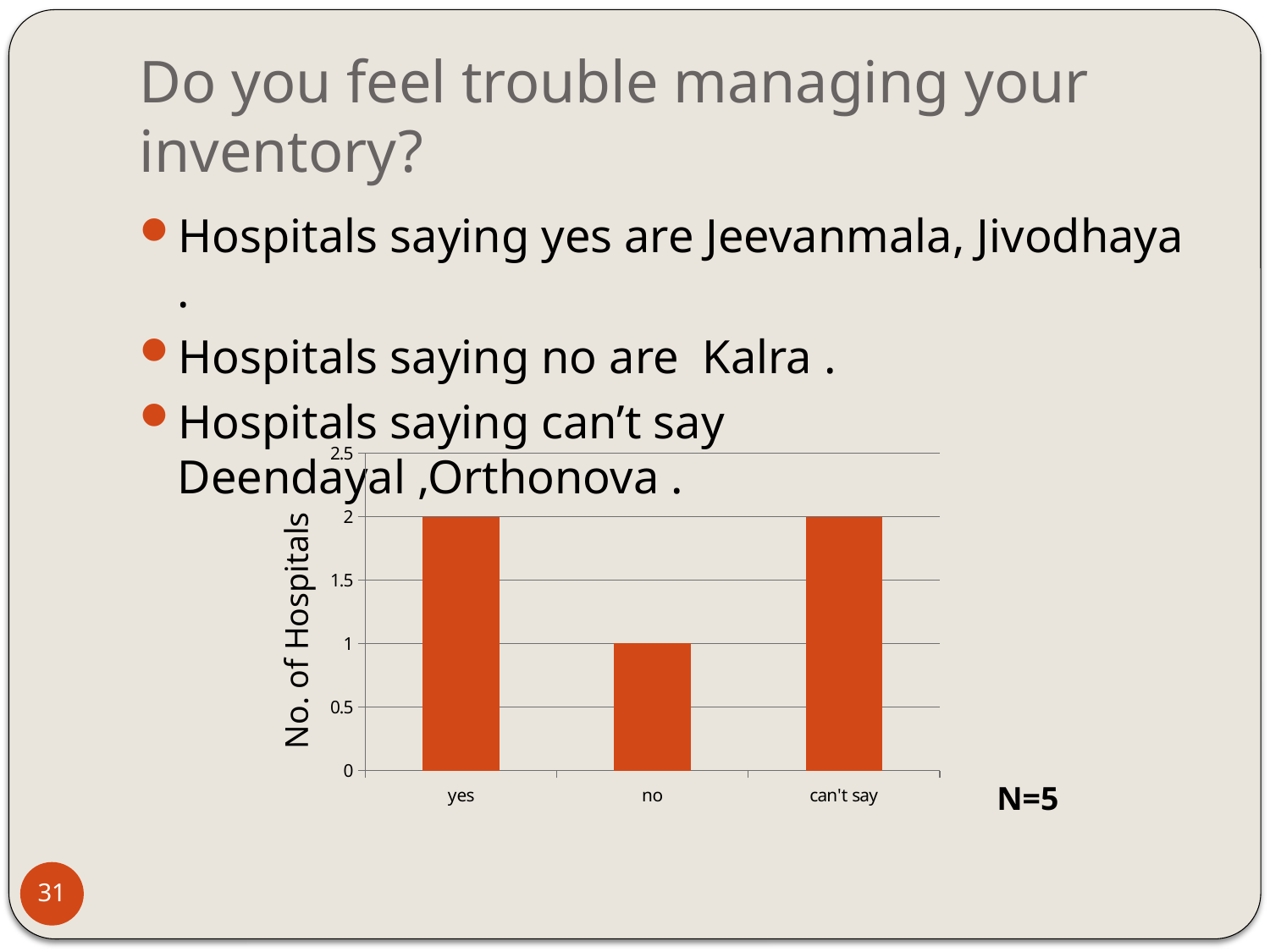
What is the difference between the values for "yes" and "no"? 1 What is the value for "yes" in the bar chart? 2 What is the value for "can't say" in the bar chart? 2 What is the label on the vertical axis of the chart? No. of Hospitals What kind of chart is shown on the slide? bar chart Is the value for "no" greater or less than 1.5? less Which category has the lowest number of hospitals in the chart? no Is the value for "can't say" greater or less than 1.5? greater How many categories are shown on the x axis of the chart? 3 Which is larger, the value for "yes" or the value for "no"? yes What colour are the bars in the chart? orange What is the value for "no" in the bar chart? 1